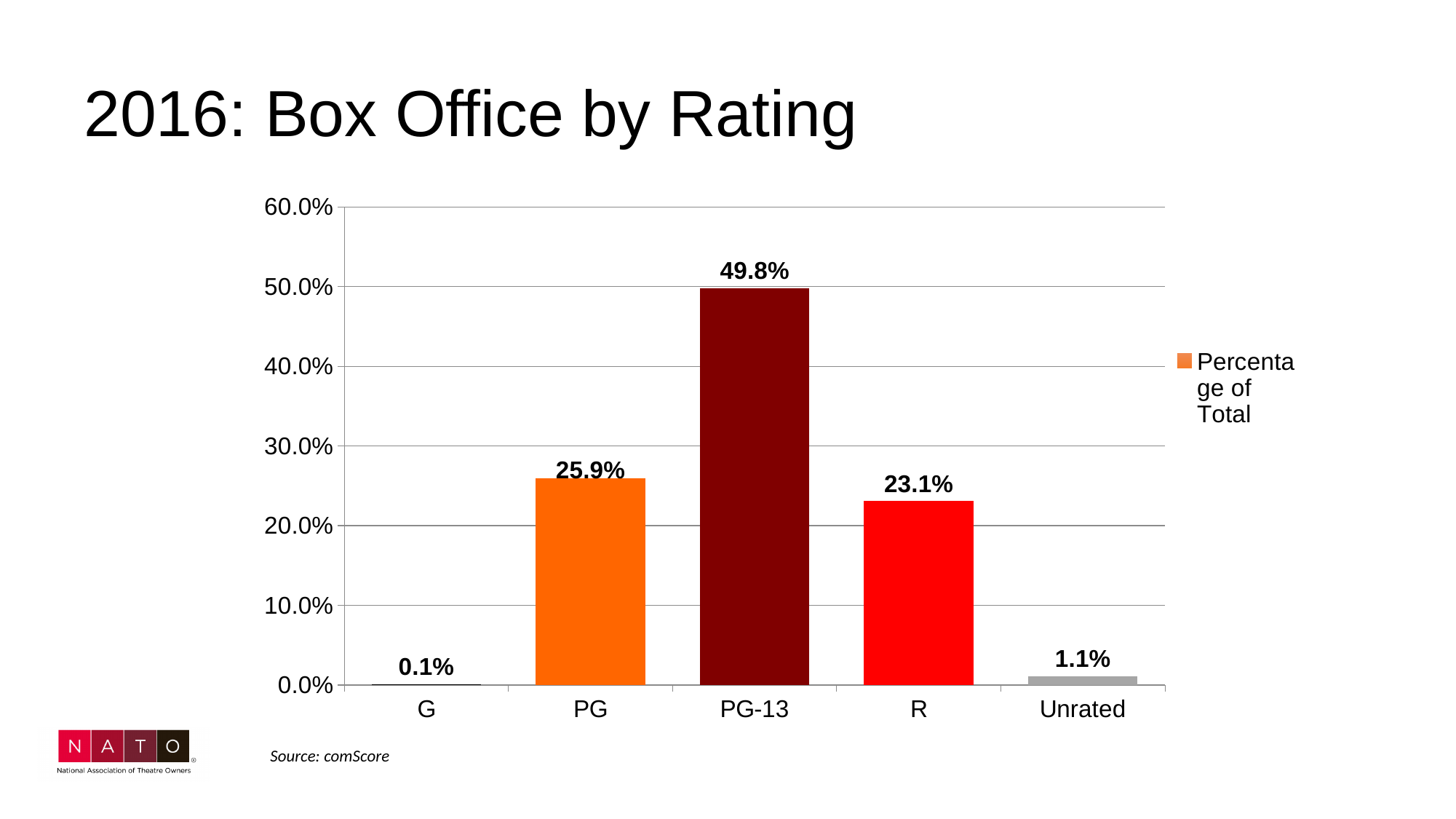
What is the difference in percentage points between PG and R? 2.8% Which rating has the highest share of box office? PG-13 Which has a larger share of box office, PG or R? PG What is the percentage of total box office for PG-13? 49.8% What is the percentage of total box office for Unrated films? 1.1% What is the title of the chart? 2016: Box Office by Rating Which rating has the lowest share of box office? G What is the difference in percentage points between PG-13 and PG? 23.9% How many rating categories are shown on the x axis? 5 What kind of chart is shown on the slide? Bar chart What is the percentage of total box office for R-rated films? 23.1% What is the percentage of total box office for G-rated films? 0.1%